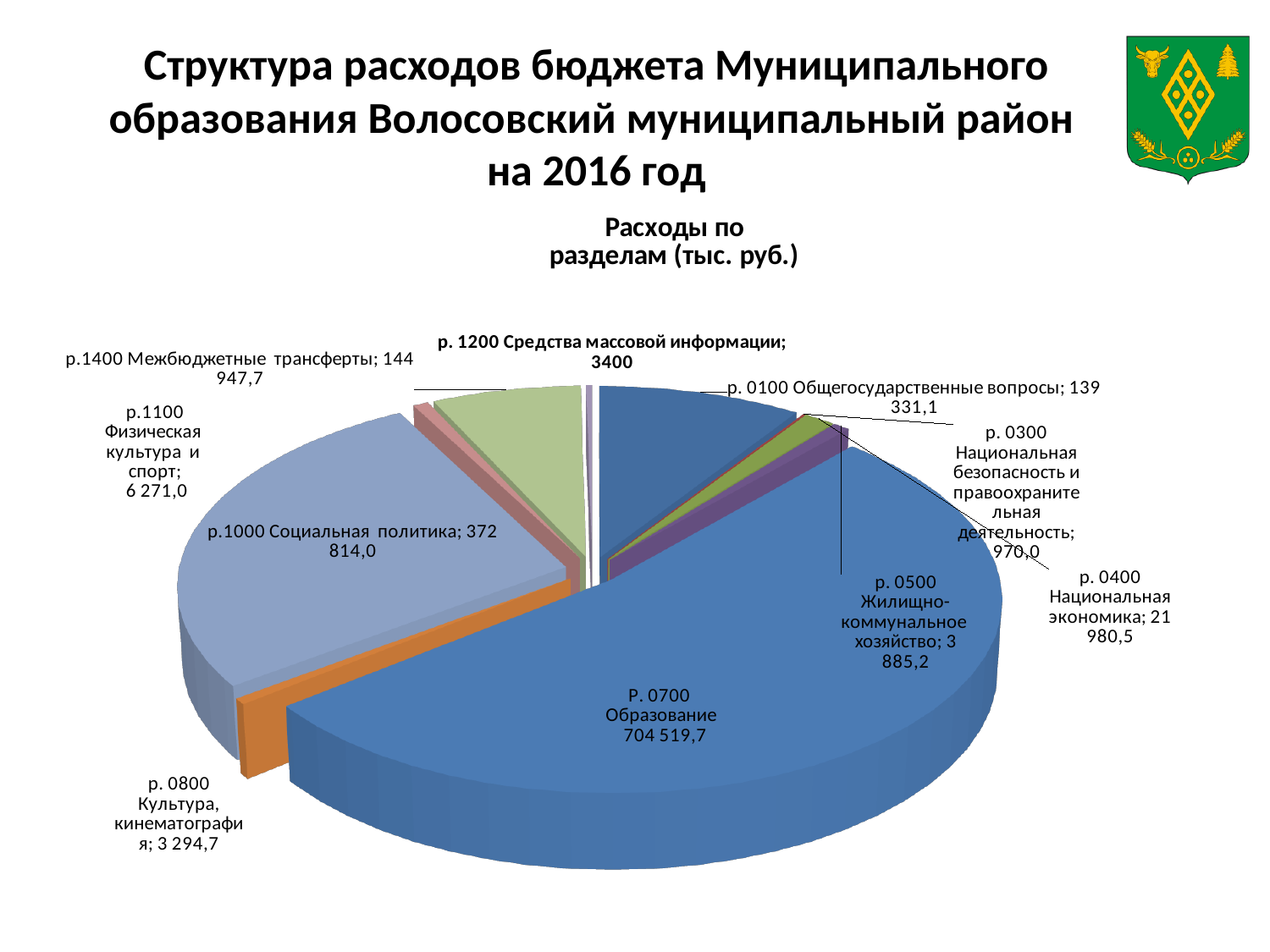
What is the value for р. 1200 Средства массовой информации? 3400 What is the value for р. 0400 Национальная экономика? 21 980,5 Which is larger: р.1400 Межбюджетные трансферты or р. 0100 Общегосударственные вопросы? р.1400 Межбюджетные трансферты What is the title of the chart? Расходы по разделам (тыс. руб.) Which section has the largest expenditure? Р. 0700 Образование What is the value for р.1000 Социальная политика? 372 814,0 What kind of chart is shown on the slide? Pie chart How many sections (slices) does the pie chart show? 10 Which section has the smallest expenditure? р. 0300 Национальная безопасность и правоохранительная деятельность What is the value for Р. 0700 Образование? 704 519,7 What is the difference between р.1100 Физическая культура и спорт and р. 0800 Культура, кинематография? 2 976,3 What is the difference between Р. 0700 Образование and р.1000 Социальная политика? 331 705,7